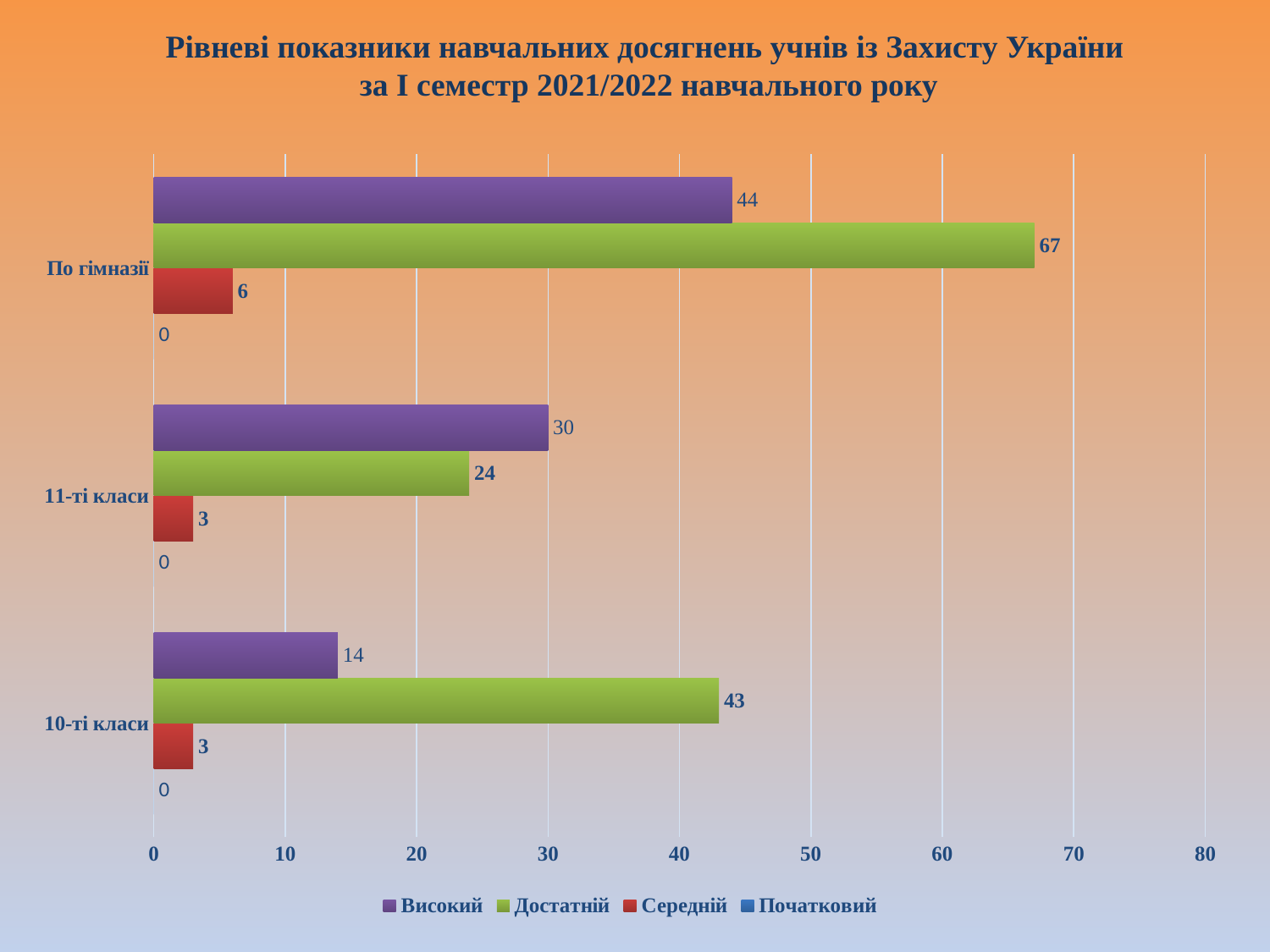
Which category has the lowest Високий value? 10-ті класи What is the value of Початковий for 11-ті класи? 0 What is the value of Достатній for По гімназії? 67 What is the value of Середній for 10-ті класи? 3 What is the difference between the Достатній and Високий values for 10-ті класи? 29 What kind of chart is shown on the slide? bar chart What is the value of Високий for 11-ті класи? 30 What colour are the Достатній bars? green How many series does the legend list? 4 How many categories are shown on the y axis? 3 Which is larger for 11-ті класи: Високий or Достатній? Високий Which category has the highest Достатній value? По гімназії